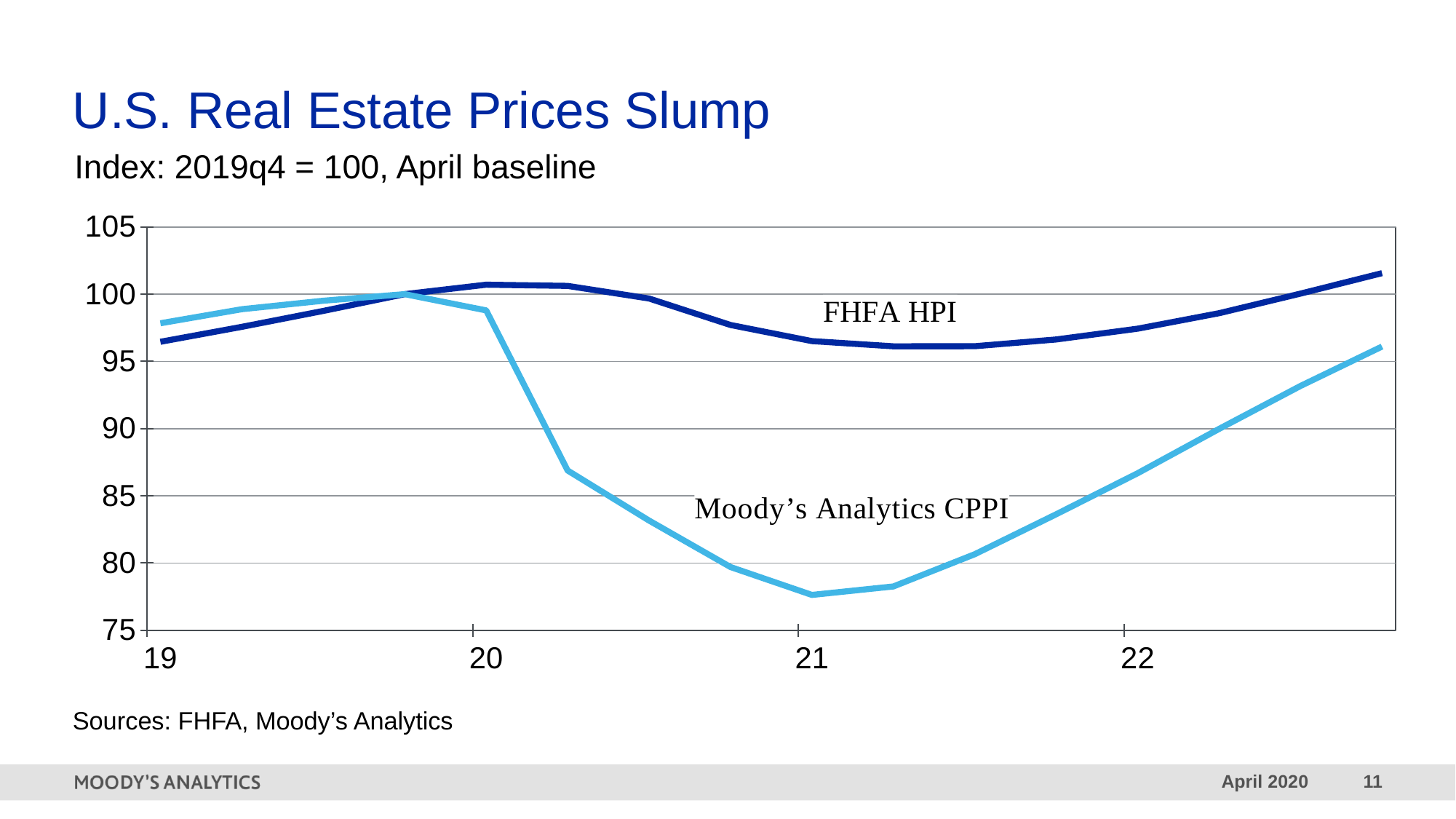
At 21, which series has the higher value, FHFA HPI or Moody's Analytics CPPI? FHFA HPI Is the value of FHFA HPI at the right end of the chart greater or less than 100? greater Is the value of Moody's Analytics CPPI at 21 greater or less than 80? less What is the title of the chart on the slide? U.S. Real Estate Prices Slump Does FHFA HPI rise or fall between 21 and 22? rise How many series are plotted on the chart? 2 Is the value of Moody's Analytics CPPI at 22 greater or less than 90? less Around which x-axis year does Moody's Analytics CPPI reach its lowest point? 21 Does Moody's Analytics CPPI rise or fall between 20 and 21? fall What are the names of the two series plotted on the chart? FHFA HPI and Moody's Analytics CPPI What kind of chart is shown on the slide? line chart